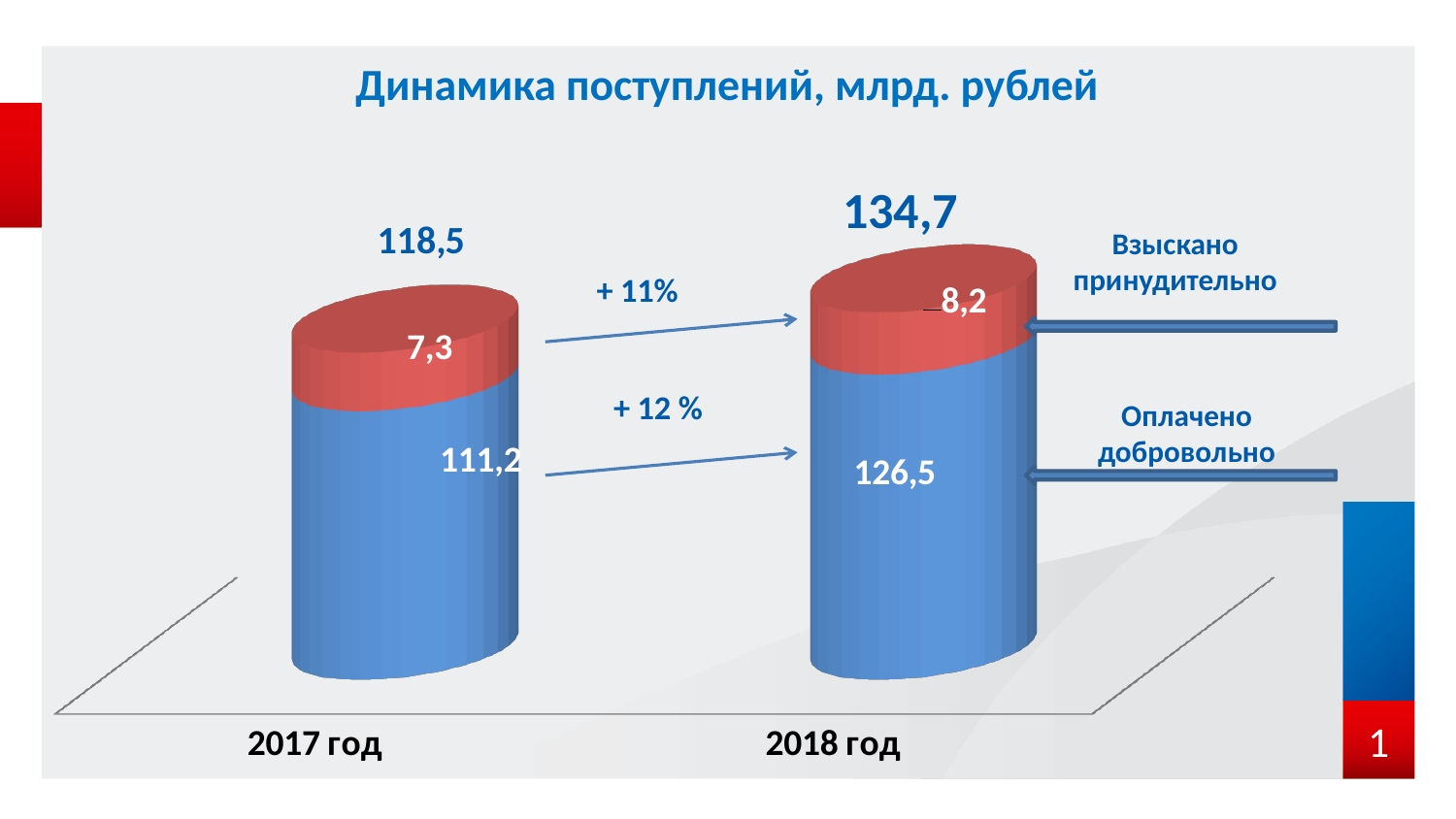
What type of chart is shown on the slide? bar chart Do the total receipts rise or fall from 2017 год to 2018 год? rise How many categories (years) are shown on the x axis? 2 What is the value for Оплачено добровольно in 2017 год? 111,2 What is the title of the chart? Динамика поступлений, млрд. рублей What is the total of the stacked bar for 2018 год? 134,7 Which year has the higher total receipts? 2018 год What is the value for Взыскано принудительно in 2017 год? 7,3 What is the total of the stacked bar for 2017 год? 118,5 What is the value for Оплачено добровольно in 2018 год? 126,5 What is the difference between the Оплачено добровольно values for 2018 год and 2017 год? 15,3 What is the value for Взыскано принудительно in 2018 год? 8,2